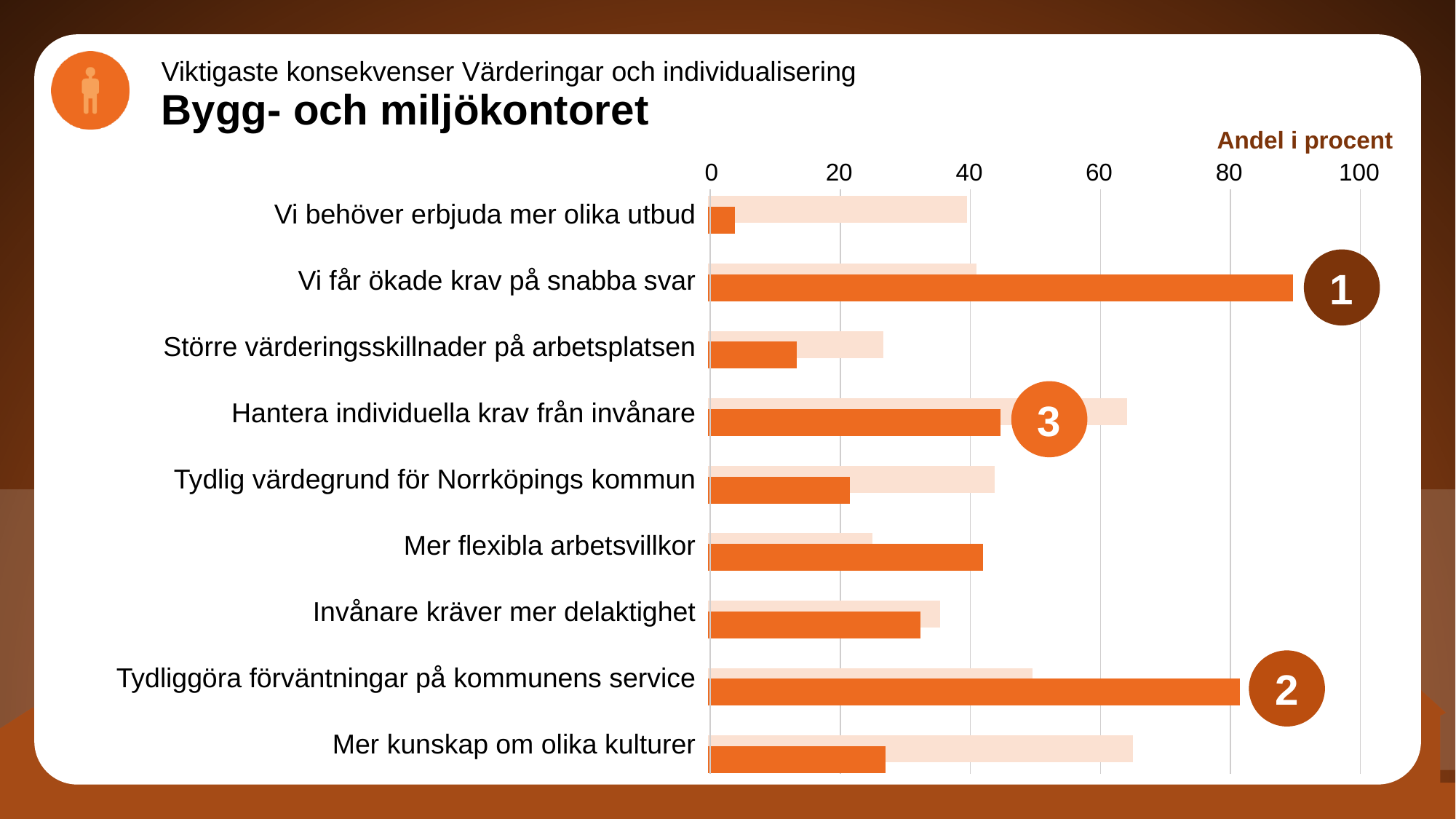
Is the light orange bar for Mer kunskap om olika kulturer greater or less than 60? greater Which category has the longest dark orange bar? Vi får ökade krav på snabba svar Which has the longer dark orange bar: Vi får ökade krav på snabba svar or Tydliggöra förväntningar på kommunens service? Vi får ökade krav på snabba svar Is the dark orange bar for Tydlig värdegrund för Norrköpings kommun greater or less than 40? less Which has the longer light orange bar: Mer kunskap om olika kulturer or Tydliggöra förväntningar på kommunens service? Mer kunskap om olika kulturer What label is shown above the horizontal axis of the chart? Andel i procent Which category has the shortest dark orange bar? Vi behöver erbjuda mer olika utbud What kind of chart is shown on the slide? bar chart How many categories are listed on the chart? 9 Which category is marked with the circle labelled 1? Vi får ökade krav på snabba svar Is the dark orange bar for Större värderingsskillnader på arbetsplatsen greater or less than 20? less